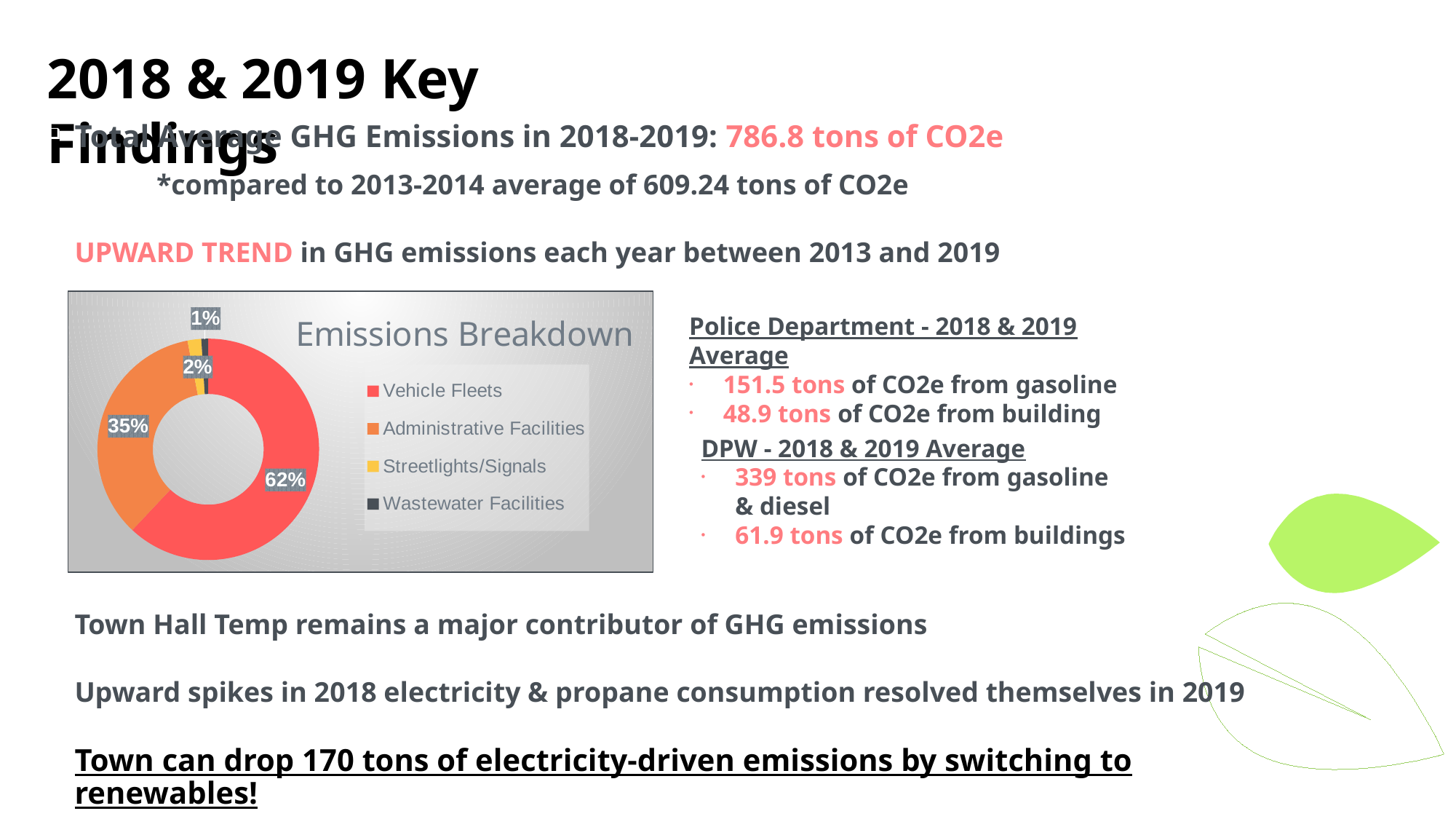
What kind of chart is the Emissions Breakdown chart? Doughnut chart Which category has the largest share in the Emissions Breakdown chart? Vehicle Fleets In the Emissions Breakdown chart, how many percentage points larger is Vehicle Fleets than Administrative Facilities? 27 What share of the Emissions Breakdown chart is Wastewater Facilities? 1% What share of the Emissions Breakdown chart is Vehicle Fleets? 62% Which category has the smallest share in the Emissions Breakdown chart? Wastewater Facilities In the Emissions Breakdown chart, which is larger: Administrative Facilities or Streetlights/Signals? Administrative Facilities What is the title of the chart on the slide? Emissions Breakdown What share of the Emissions Breakdown chart is Streetlights/Signals? 2% What colour represents Administrative Facilities in the Emissions Breakdown chart? Orange How many categories are shown in the Emissions Breakdown chart? 4 What share of the Emissions Breakdown chart is Administrative Facilities? 35%